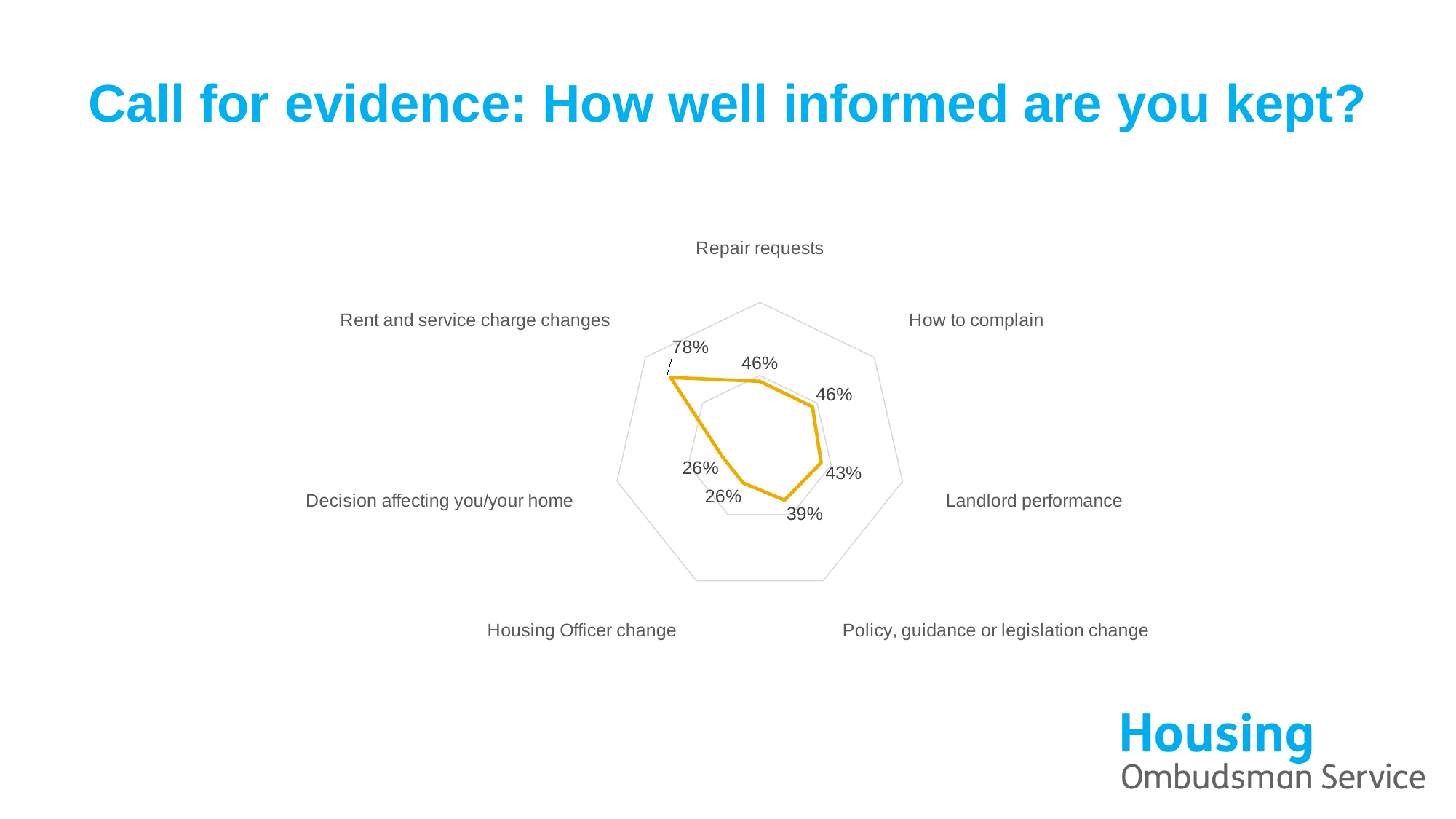
What is the value for Landlord performance? 43% Which category has the highest value? Rent and service charge changes What type of chart is shown on the slide? Radar chart Which is larger, the value for How to complain or the value for Landlord performance? How to complain What is the value for Rent and service charge changes? 78% How many categories does the chart show? 7 What is the difference between the values for Rent and service charge changes and Repair requests? 32% What is the difference between the values for Landlord performance and Policy, guidance or legislation change? 4% What is the value for Repair requests? 46% What is the value for Policy, guidance or legislation change? 39% What is the value for Housing Officer change? 26% What is the title of the slide? Call for evidence: How well informed are you kept?